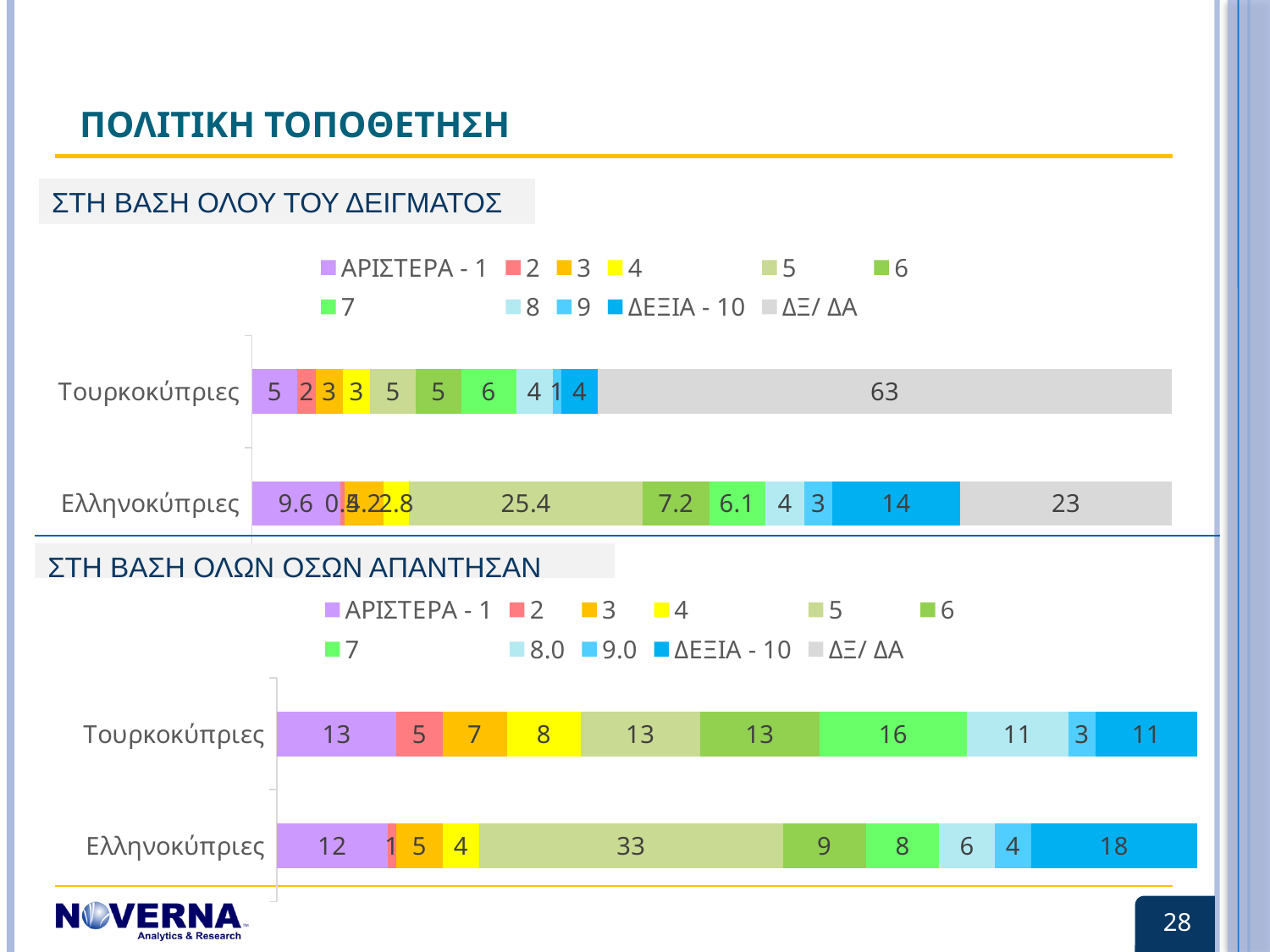
In the bottom chart (ΣΤΗ ΒΑΣΗ ΟΛΩΝ ΟΣΩΝ ΑΠΑΝΤΗΣΑΝ), which series has the largest value for Ελληνοκύπριες? 5 What kind of chart is the top chart (ΣΤΗ ΒΑΣΗ ΟΛΟΥ ΤΟΥ ΔΕΙΓΜΑΤΟΣ)? Stacked bar chart In the bottom chart (ΣΤΗ ΒΑΣΗ ΟΛΩΝ ΟΣΩΝ ΑΠΑΝΤΗΣΑΝ), what is the ΔΕΞΙΑ - 10 value for Ελληνοκύπριες? 18 In the bottom chart (ΣΤΗ ΒΑΣΗ ΟΛΩΝ ΟΣΩΝ ΑΠΑΝΤΗΣΑΝ), what is the value of series 5 for Ελληνοκύπριες? 33 In the top chart (ΣΤΗ ΒΑΣΗ ΟΛΟΥ ΤΟΥ ΔΕΙΓΜΑΤΟΣ), what is the difference between the ΔΞ/ΔΑ values for Τουρκοκύπριες and Ελληνοκύπριες? 40 In the bottom chart (ΣΤΗ ΒΑΣΗ ΟΛΩΝ ΟΣΩΝ ΑΠΑΝΤΗΣΑΝ), what is the value of series 7 for Τουρκοκύπριες? 16 In the top chart (ΣΤΗ ΒΑΣΗ ΟΛΟΥ ΤΟΥ ΔΕΙΓΜΑΤΟΣ), what is the ΔΞ/ΔΑ value for Τουρκοκύπριες? 63 In the top chart (ΣΤΗ ΒΑΣΗ ΟΛΟΥ ΤΟΥ ΔΕΙΓΜΑΤΟΣ), what is the value of series 5 for Ελληνοκύπριες? 25.4 In the top chart (ΣΤΗ ΒΑΣΗ ΟΛΟΥ ΤΟΥ ΔΕΙΓΜΑΤΟΣ), what is the ΔΞ/ΔΑ value for Ελληνοκύπριες? 23 In the bottom chart (ΣΤΗ ΒΑΣΗ ΟΛΩΝ ΟΣΩΝ ΑΠΑΝΤΗΣΑΝ), which group has the larger ΑΡΙΣΤΕΡΑ - 1 value, Τουρκοκύπριες or Ελληνοκύπριες? Τουρκοκύπριες In the top chart (ΣΤΗ ΒΑΣΗ ΟΛΟΥ ΤΟΥ ΔΕΙΓΜΑΤΟΣ), what is the ΑΡΙΣΤΕΡΑ - 1 value for Ελληνοκύπριες? 9.6 In the top chart (ΣΤΗ ΒΑΣΗ ΟΛΟΥ ΤΟΥ ΔΕΙΓΜΑΤΟΣ), what is the ΔΕΞΙΑ - 10 value for Ελληνοκύπριες? 14